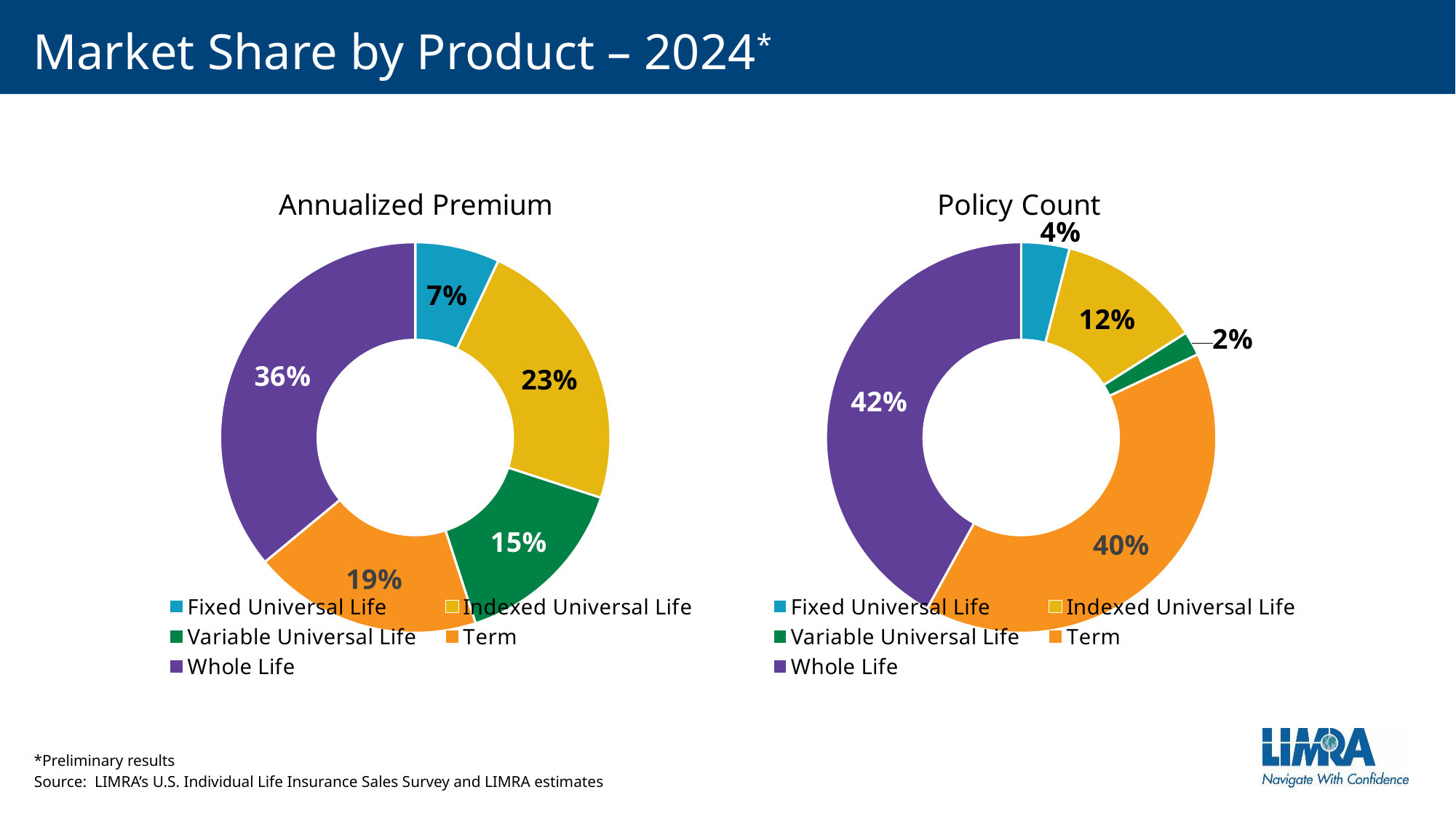
In the Annualized Premium chart, what share does Whole Life have? 36% In the Annualized Premium chart, which product has the smallest share? Fixed Universal Life In the Policy Count chart, what share does Variable Universal Life have? 2% In the Policy Count chart, which is larger, the share for Indexed Universal Life or the share for Fixed Universal Life? Indexed Universal Life Which colour represents Term in the legends of both charts? Orange In the Policy Count chart, what is the combined share of Term and Whole Life? 82% In the Policy Count chart, what share does Term have? 40% In the Policy Count chart, which product has the largest share? Whole Life In the Annualized Premium chart, what is the difference between the Whole Life share and the Term share? 17% In the Annualized Premium chart, what share does Indexed Universal Life have? 23% How many product categories does the Annualized Premium chart show? 5 What type of chart is the Policy Count chart? Pie chart (doughnut)